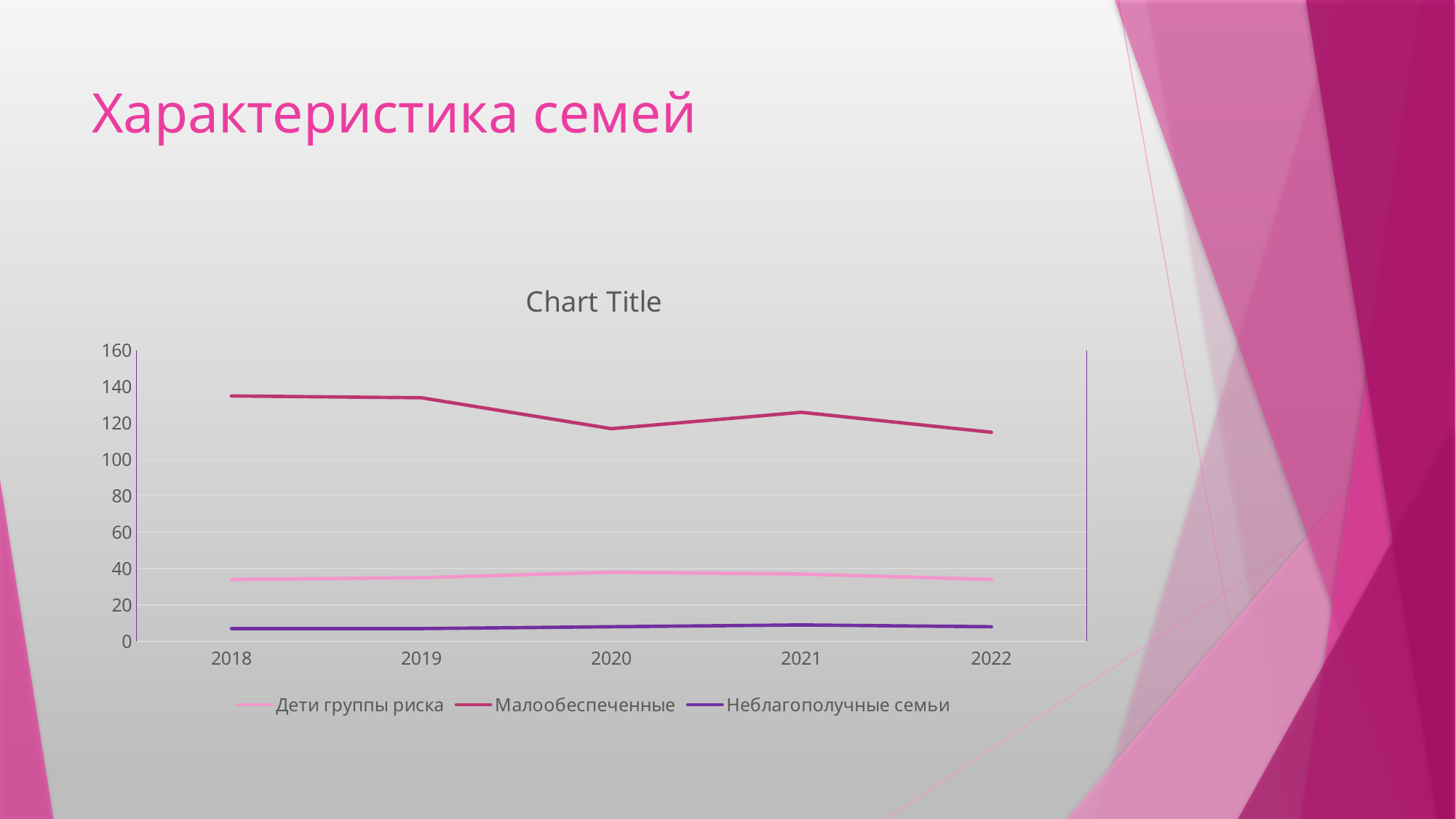
Does the Малообеспеченные line rise or fall from 2018 to 2020? fall Is the value for Неблагополучные семьи in 2021 greater or less than 20? less How many years are shown on the x axis? 5 Which series has the highest values across all years? Малообеспеченные In 2020, which is larger: the value for Малообеспеченные or the value for Дети группы риска? Малообеспеченные What is the title shown above the chart? Chart Title How many series does the legend list? 3 What kind of chart is shown on the slide? line chart Which series has the lowest values across all years? Неблагополучные семьи Is the value for Малообеспеченные in 2018 greater or less than 120? greater